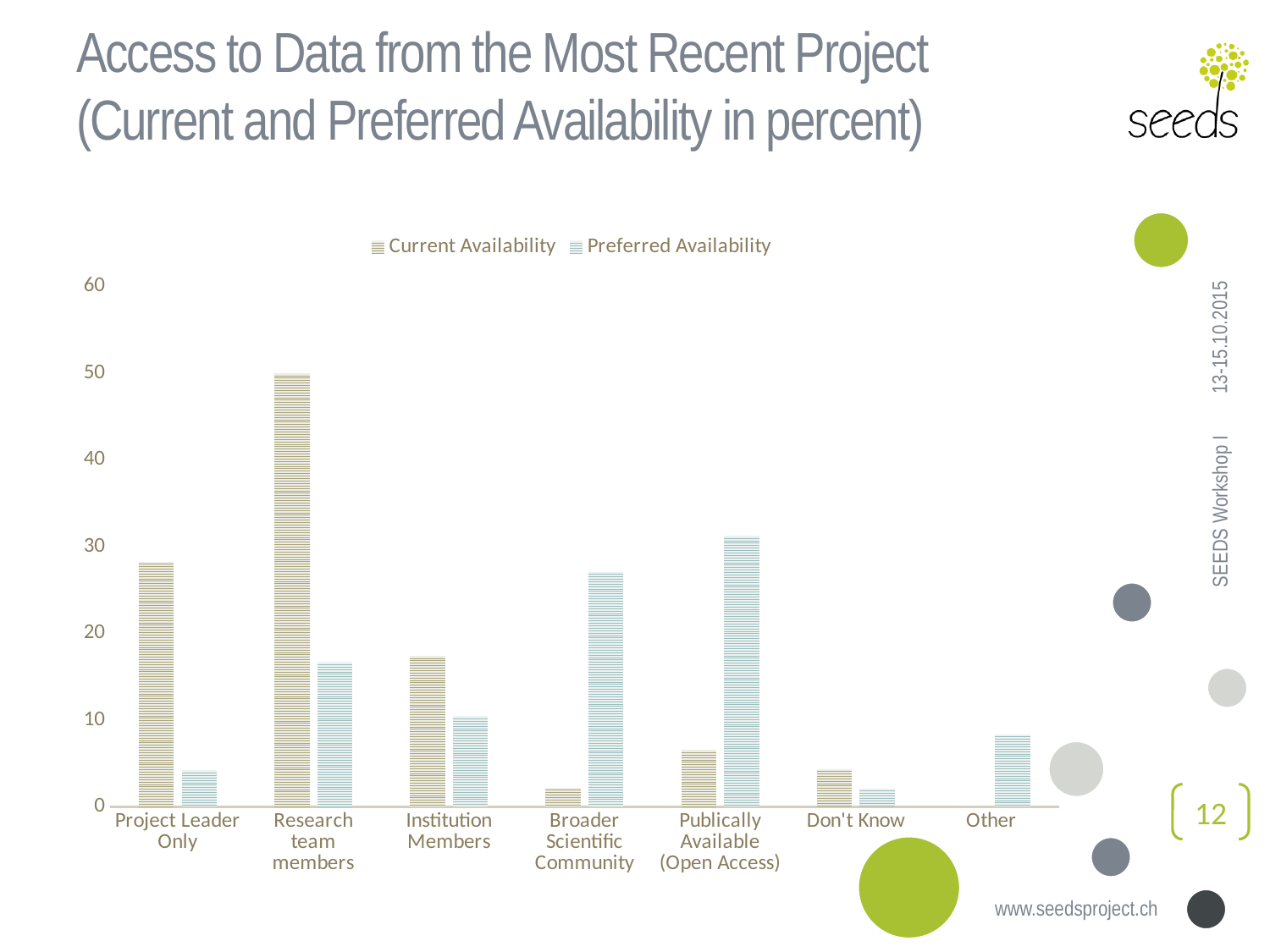
What kind of chart is shown on the slide? Bar chart Which category has the lowest Current Availability value? Other For Project Leader Only, which is larger: Current Availability or Preferred Availability? Current Availability Is the Current Availability value for Project Leader Only greater or less than 20? greater Is the Preferred Availability value for Institution Members greater or less than 20? less Is the Current Availability value for Research team members greater or less than 40? greater What are the two series named in the legend? Current Availability and Preferred Availability Which category has the highest Current Availability value? Research team members Which category has the highest Preferred Availability value? Publically Available (Open Access) How many categories are shown on the x axis? 7 How many series does the legend list? 2